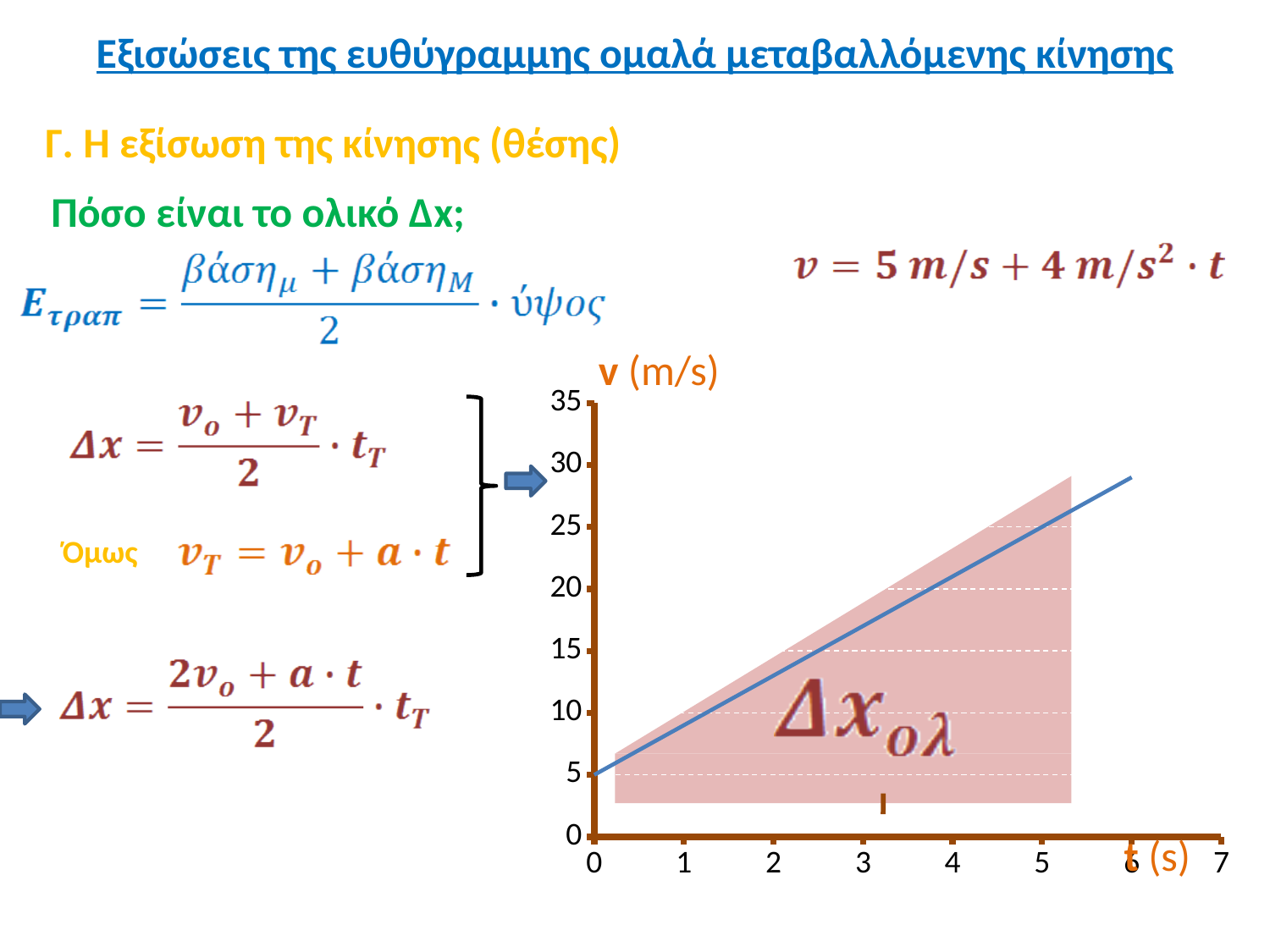
What is the highest tick value shown on the vertical axis? 35 What kind of chart is shown on the slide? line chart How many lines (series) are plotted on the chart? 1 Is the value of v at t = 1 greater or less than 10? less Is the value of v at t = 6 greater or less than 30? less Does the velocity v rise or fall as t increases along the x axis? rises Which is larger, the value of v at t = 2 or at t = 5? t = 5 What is the label of the vertical axis of the chart? v (m/s) Is the value of v at t = 3 greater or less than 15? greater What is the value of v at t = 0 on the chart? 5 What is the label of the horizontal axis of the chart? t (s)